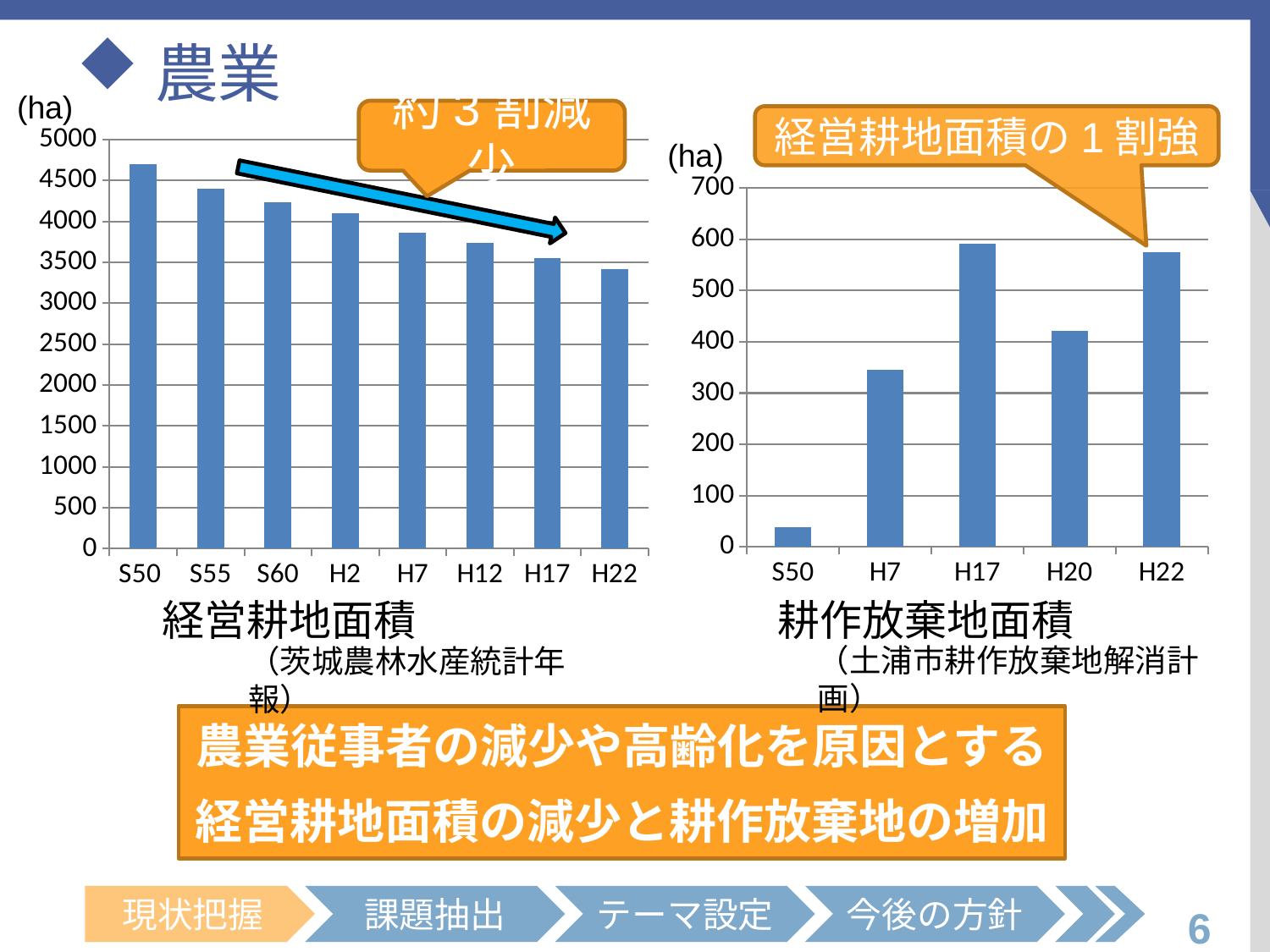
How many categories are shown on the x axis of the 耕作放棄地面積 chart on the right? 5 How many categories are shown on the x axis of the 経営耕地面積 chart on the left? 8 In the 耕作放棄地面積 chart on the right, which is larger, the value for H17 or the value for H7? H17 What kind of chart is the 経営耕地面積 chart on the left? bar chart In the 耕作放棄地面積 chart on the right, is the value for S50 greater or less than 100? less In the 経営耕地面積 chart on the left, which category has the lowest value? H22 What unit is shown on the y axis of the 耕作放棄地面積 chart on the right? ha In the 経営耕地面積 chart on the left, is the value for S50 greater or less than 4500? greater In the 経営耕地面積 chart on the left, which category has the highest value? S50 In the 経営耕地面積 chart on the left, do the values rise or fall from S50 to H22? fall In the 経営耕地面積 chart on the left, is the value for H22 greater or less than 3500? less In the 耕作放棄地面積 chart on the right, which category has the lowest value? S50